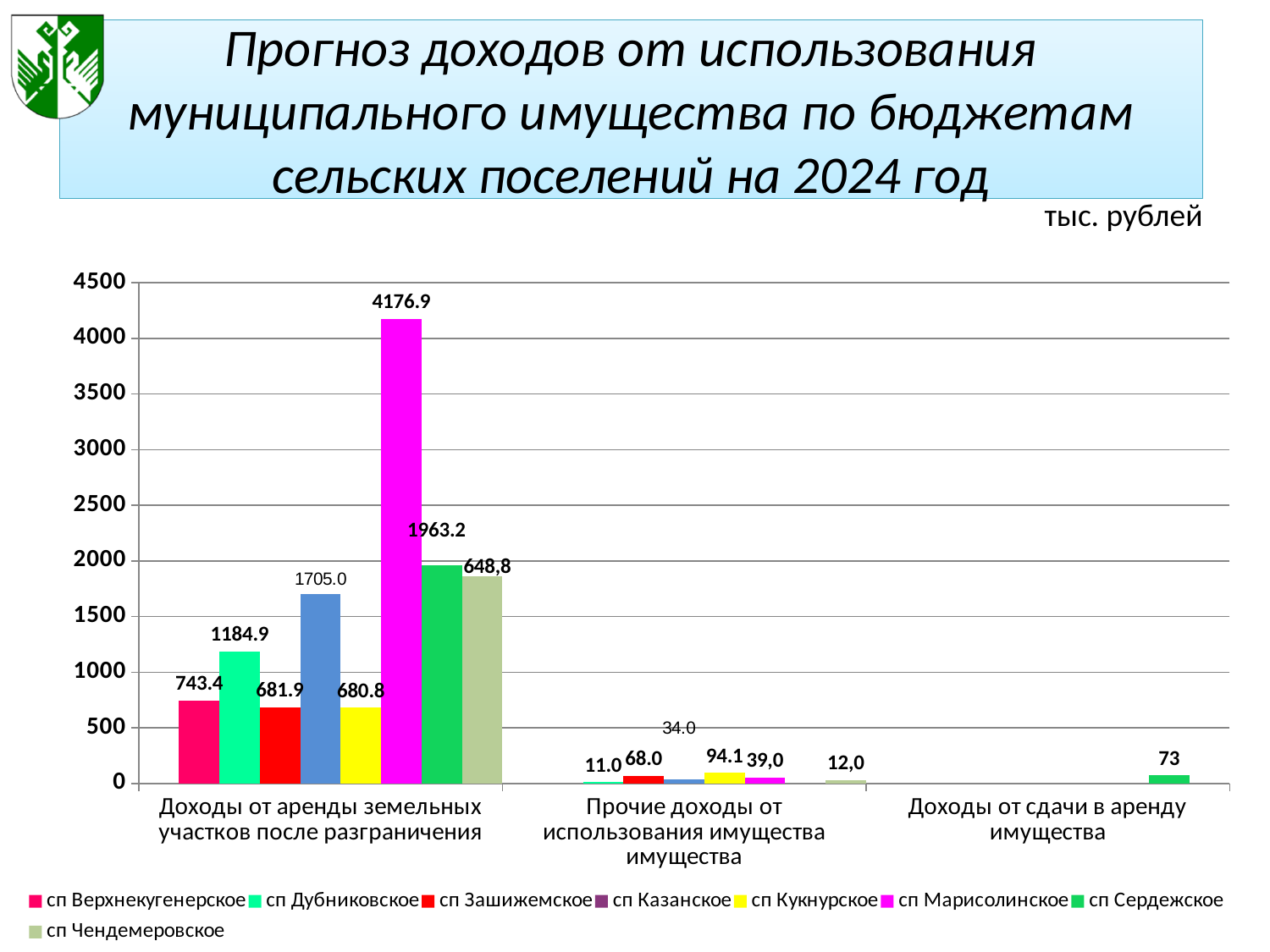
What is the value for сп Сердежское in the category 'Доходы от аренды земельных участков после разграничения'? 1963.2 What kind of chart is shown on the slide? bar chart How many categories are shown on the x axis? 3 What is the value for сп Куккнурское in the category 'Прочие доходы от использования имущества'? 94.1 In what units are the values on the chart given? тыс. рублей In the category 'Доходы от аренды земельных участков после разграничения', which is larger: сп Дубниковское or сп Верхнекугенерское? сп Дубниковское Which settlement has the highest value in the category 'Доходы от аренды земельных участков после разграничения'? сп Марисолинское Is the value for сп Казанское in the category 'Доходы от аренды земельных участков после разграничения' greater or less than 1500? greater What is the difference between the values for сп Марисолинское and сп Сердежское in the category 'Доходы от аренды земельных участков после разграничения'? 2213.7 How many series does the legend list? 8 What is the value for сп Сердежское in the category 'Доходы от сдачи в аренду имущества'? 73 What is the value for сп Марисолинское in the category 'Доходы от аренды земельных участков после разграничения'? 4176.9